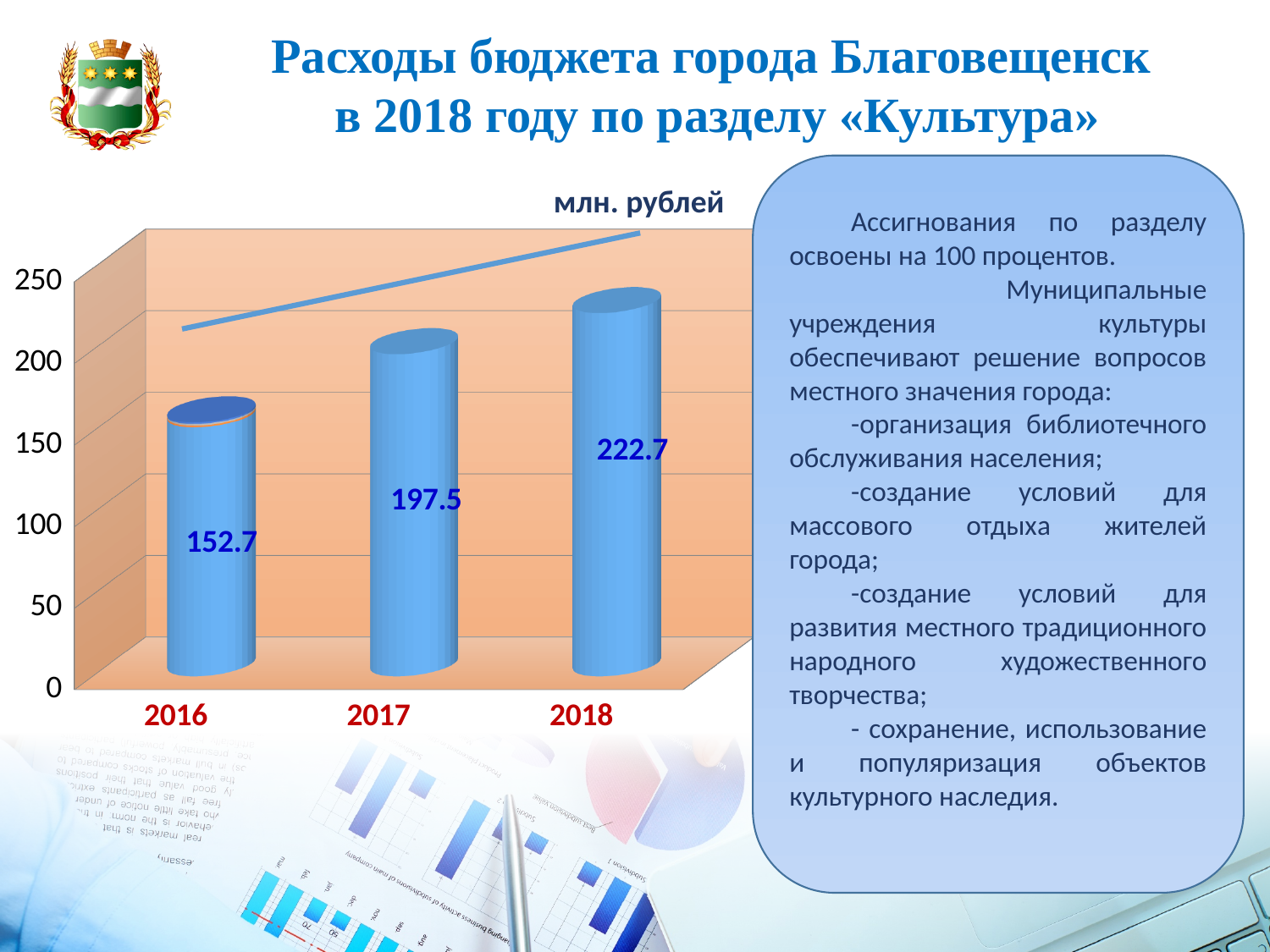
How many years are shown on the chart? 3 What is the value for 2017? 197.5 What is the value for 2016? 152.7 Is the value for 2018 greater or less than 200? greater Which is larger, the value for 2016 or the value for 2017? 2017 Which year has the lowest value? 2016 Do the values rise or fall from 2016 to 2018? rise What is the value for 2018? 222.7 What is the difference between the values for 2018 and 2017? 25.2 What kind of chart is shown on the slide? bar chart Which year has the highest value? 2018 What is the difference between the values for 2017 and 2016? 44.8